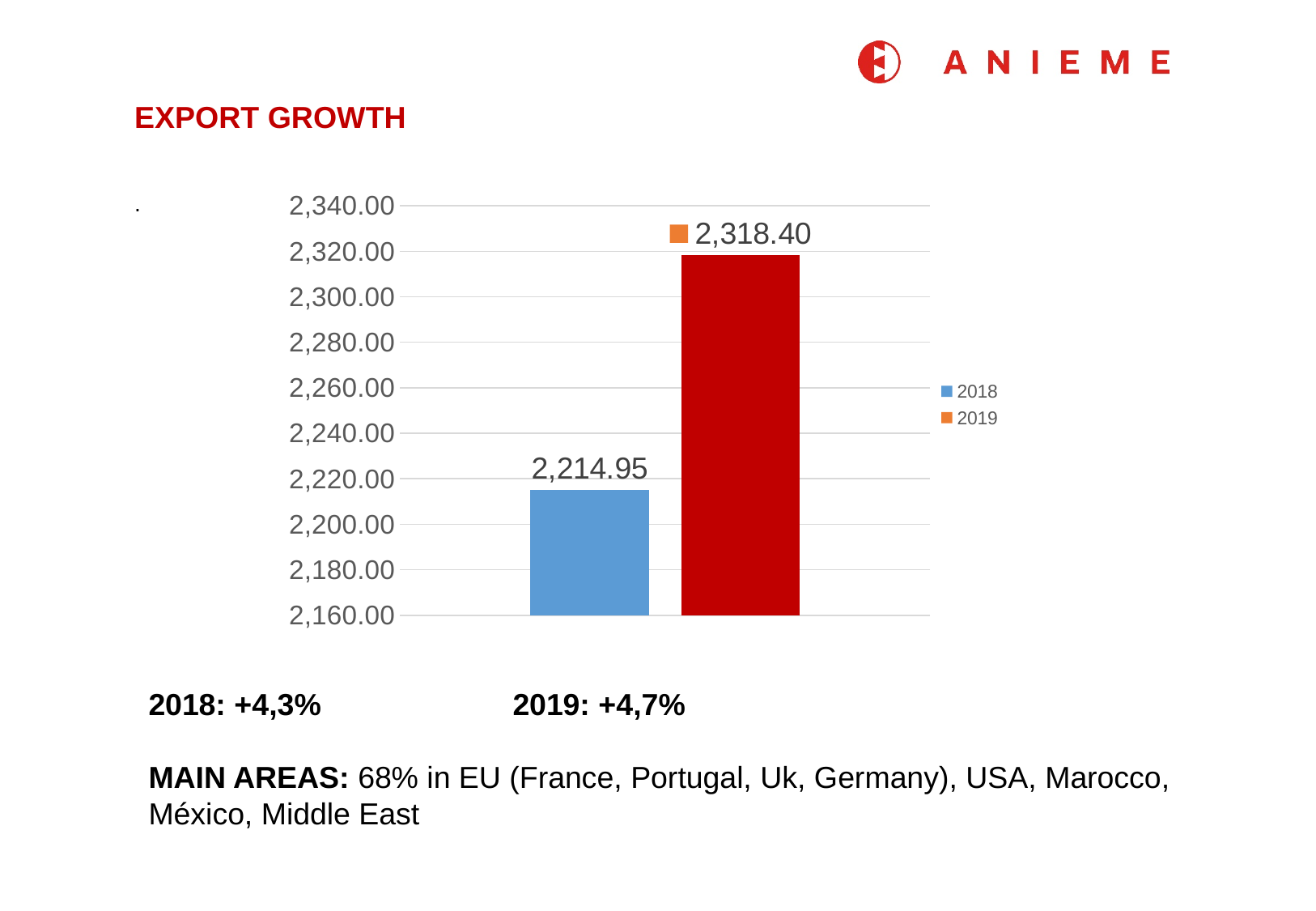
What is the value shown for 2018? 2,214.95 What is the value shown for 2019? 2,318.40 Do the values rise or fall from 2018 to 2019? Rise Which year has the lowest value in the chart? 2018 Which year has the higher value, 2018 or 2019? 2019 How many bars are plotted in the chart? 2 Is the value for 2018 greater or less than 2,200.00? greater What kind of chart is shown on the slide? Bar chart Which year has the highest value in the chart? 2019 How many series does the legend list? 2 Is the value for 2019 greater or less than 2,300.00? greater What is the difference between the 2019 value and the 2018 value? 103.45